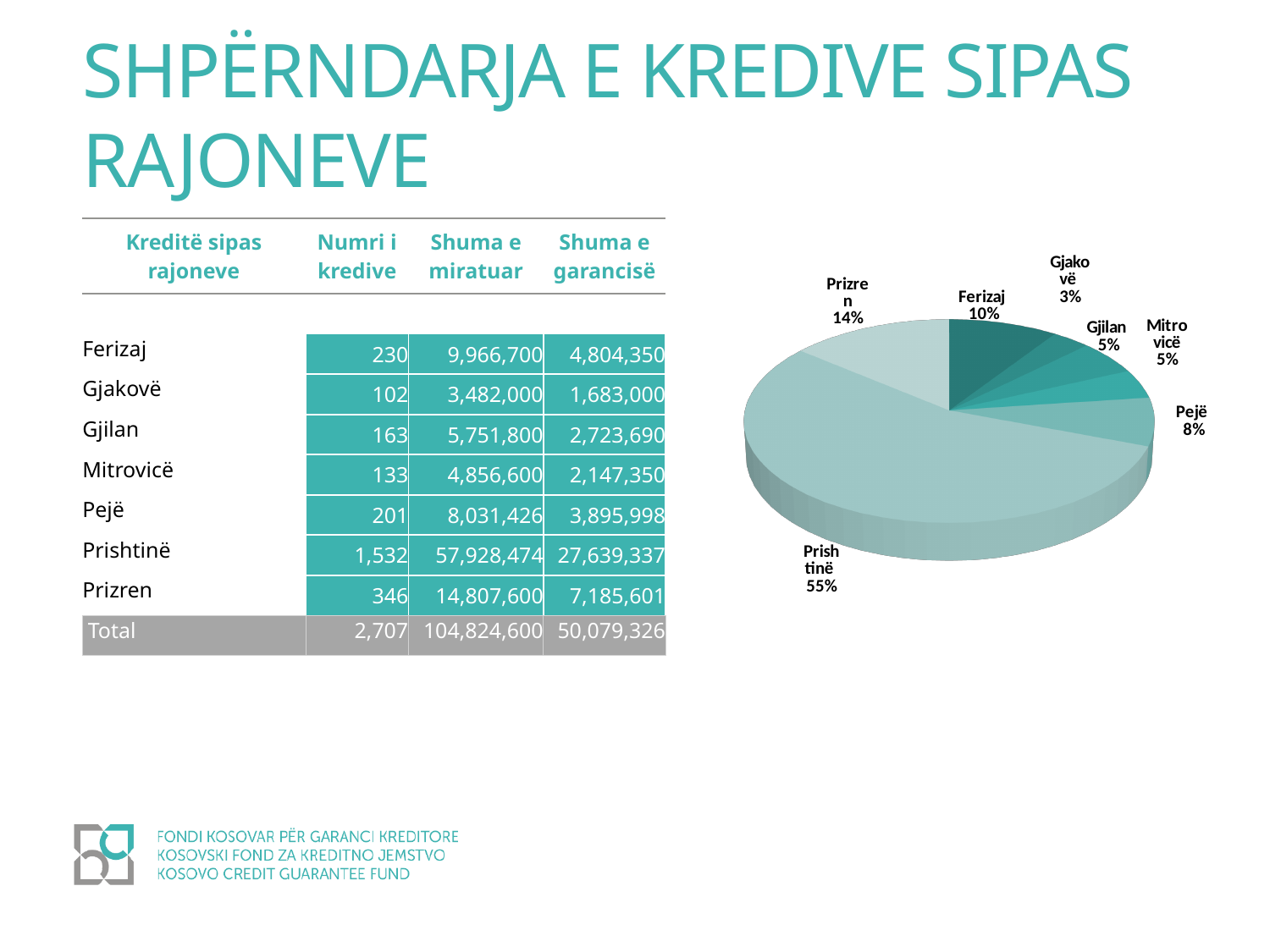
What kind of chart is shown on the slide? pie chart What is the difference in percentage points between the Prishtinë slice and the Prizren slice? 41% How many slices does the pie chart have? 7 Which slice is larger in the pie chart, Prizren or Ferizaj? Prizren What percentage is shown for Gjakovë in the pie chart? 3% Which region has the largest slice in the pie chart? Prishtinë What is the difference in percentage points between the Pejë slice and the Gjilan slice? 3% What percentage is shown for Pejë in the pie chart? 8% What share of the pie does Prishtinë hold? 55% What percentage is shown for Prizren in the pie chart? 14% Which region has the smallest slice in the pie chart? Gjakovë What percentage is shown for Ferizaj in the pie chart? 10%